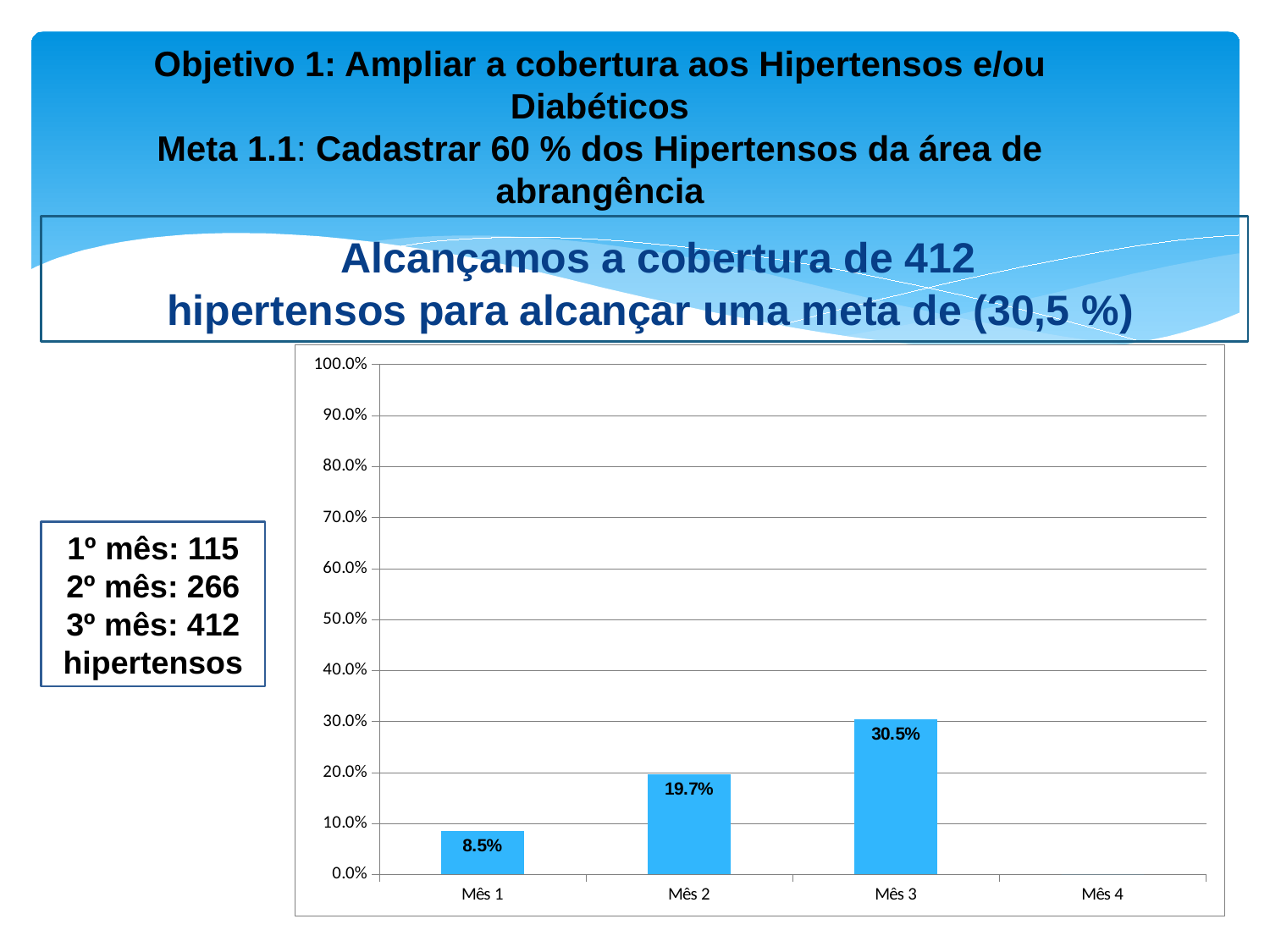
What is the value for Mês 1? 8.5% What is the difference between the values for Mês 3 and Mês 1? 22.0% What is the value for Mês 2? 19.7% How many categories are shown on the x axis? 4 Which month has the highest value? Mês 3 What kind of chart is shown on the slide? bar chart Which is larger, the value for Mês 2 or the value for Mês 3? Mês 3 Which month with a plotted bar has the lowest value? Mês 1 What is the value for Mês 3? 30.5% What is the difference between the values for Mês 2 and Mês 1? 11.2% Is the value for Mês 3 greater or less than 40%? less Do the values rise or fall from Mês 1 to Mês 3? rise